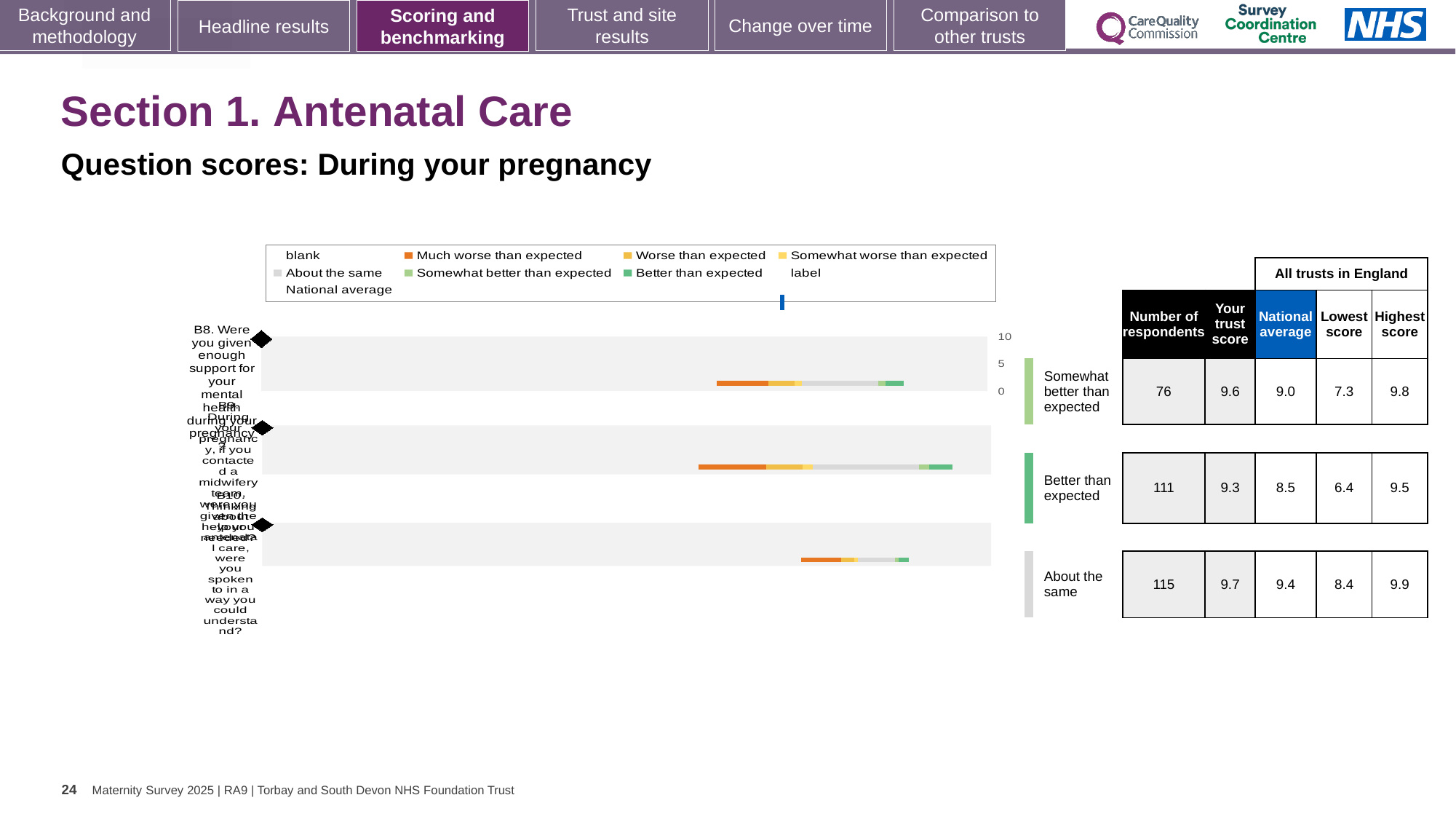
In the table, what is the lowest score for the row rated 'Better than expected'? 6.4 What kind of chart is shown on the slide? bar chart How many question rows (bars) are plotted in the chart? 3 Is the trust score for the row rated 'Better than expected' larger or smaller than its national average? larger Which row in the table has the highest number of respondents? About the same (115) In the table, what is the highest score for the bottom row (rated 'About the same')? 9.9 What is the heading above the 'National average', 'Lowest score' and 'Highest score' columns in the table? All trusts in England In the table, what is the number of respondents for the top row (rated 'Somewhat better than expected')? 76 In the table, what is the trust score for the row rated 'Better than expected'? 9.3 Which row in the table has the lowest trust score? Better than expected (9.3) In the table, what is the national average for the bottom row (rated 'About the same')? 9.4 What is the difference between the trust score and the national average for the top row (rated 'Somewhat better than expected')? 0.6